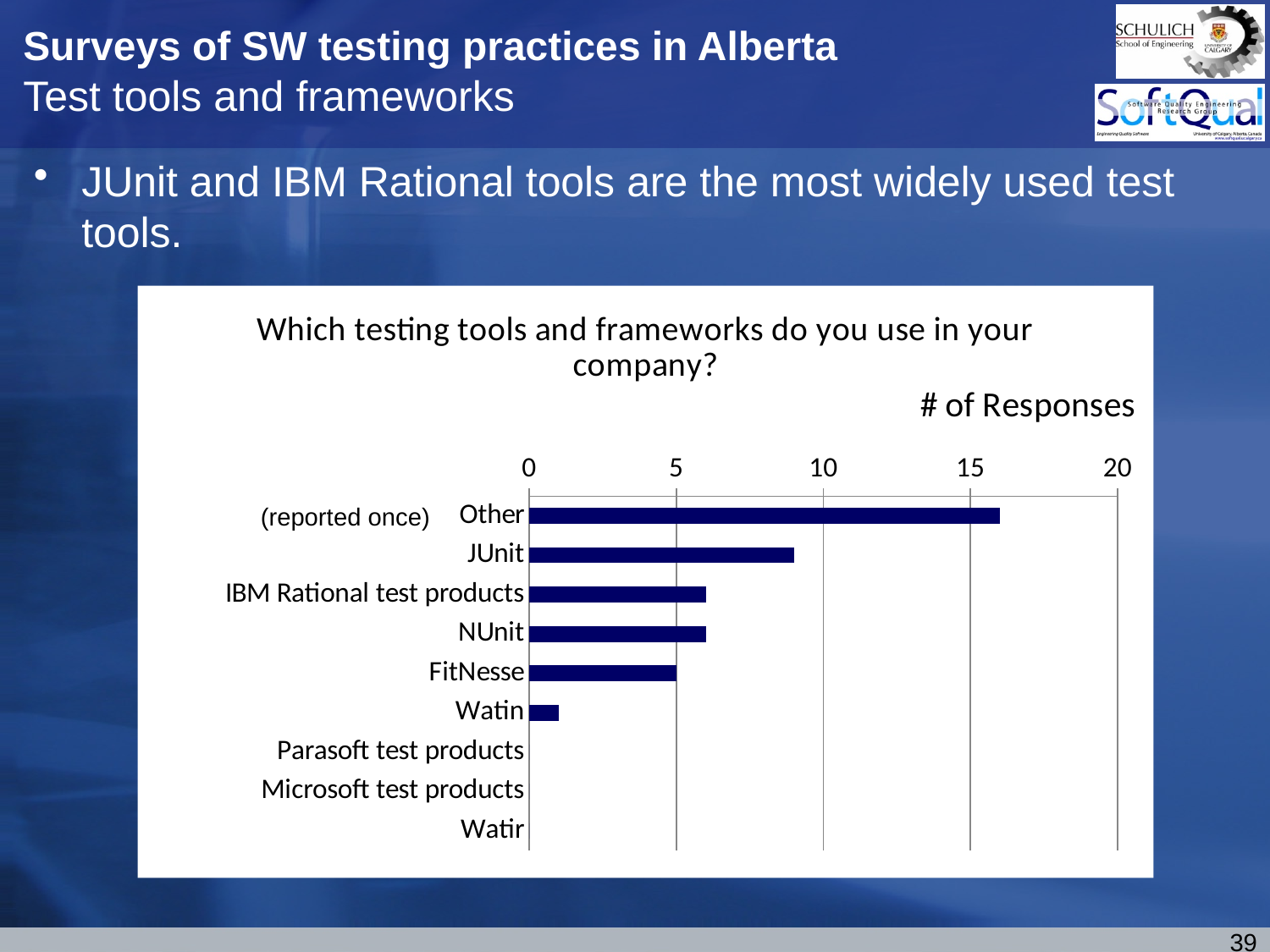
Which category has the highest number of responses? Other Which has more responses, JUnit or NUnit? JUnit Is the value for Watin greater or less than 5? less Is the value for JUnit greater or less than 5? greater Is the value for JUnit greater or less than 10? less Which has more responses, Other or JUnit? Other How many categories (tools/frameworks) are listed on the chart? 9 What type of chart is shown on the slide? bar chart What label is shown on the value axis of the chart? # of Responses What is the title of the chart? Which testing tools and frameworks do you use in your company?